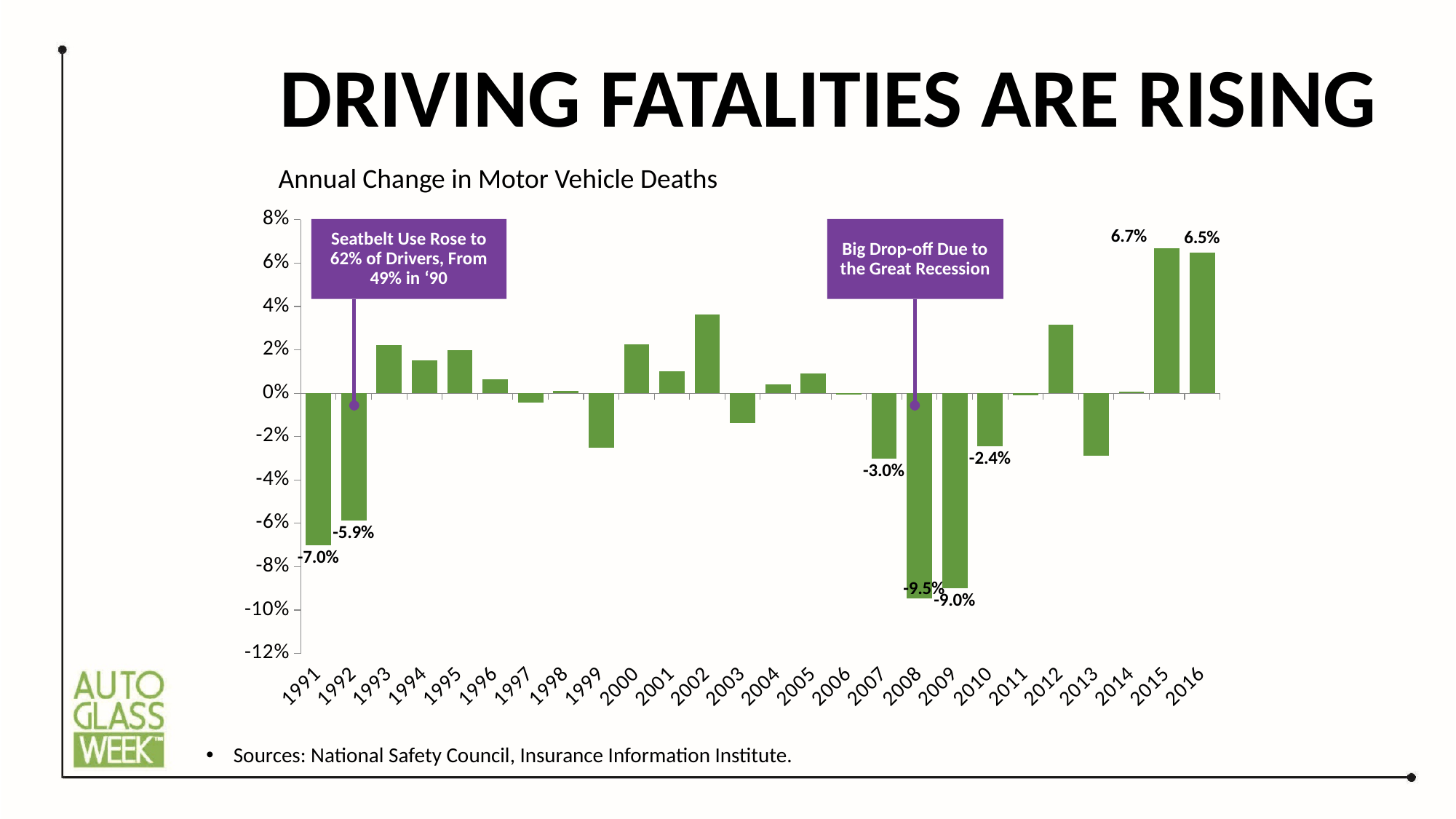
Is the value for 2002 greater or less than 2%? greater What is the difference between the values for 2015 and 2016? 0.2 percentage points Which year has the lowest annual change in motor vehicle deaths? 2008 What is the value shown for 2015? 6.7% Which year has the larger decline, 1991 or 1992? 1991 What is the title of the chart? Annual Change in Motor Vehicle Deaths Which year has the highest annual change in motor vehicle deaths? 2015 How many years are shown on the x axis? 26 What is the value shown for 2010? -2.4% What is the annual change in motor vehicle deaths shown for 1991? -7.0% What kind of chart is shown on the slide? Bar chart What value is labeled on the bar for 2008? -9.5%